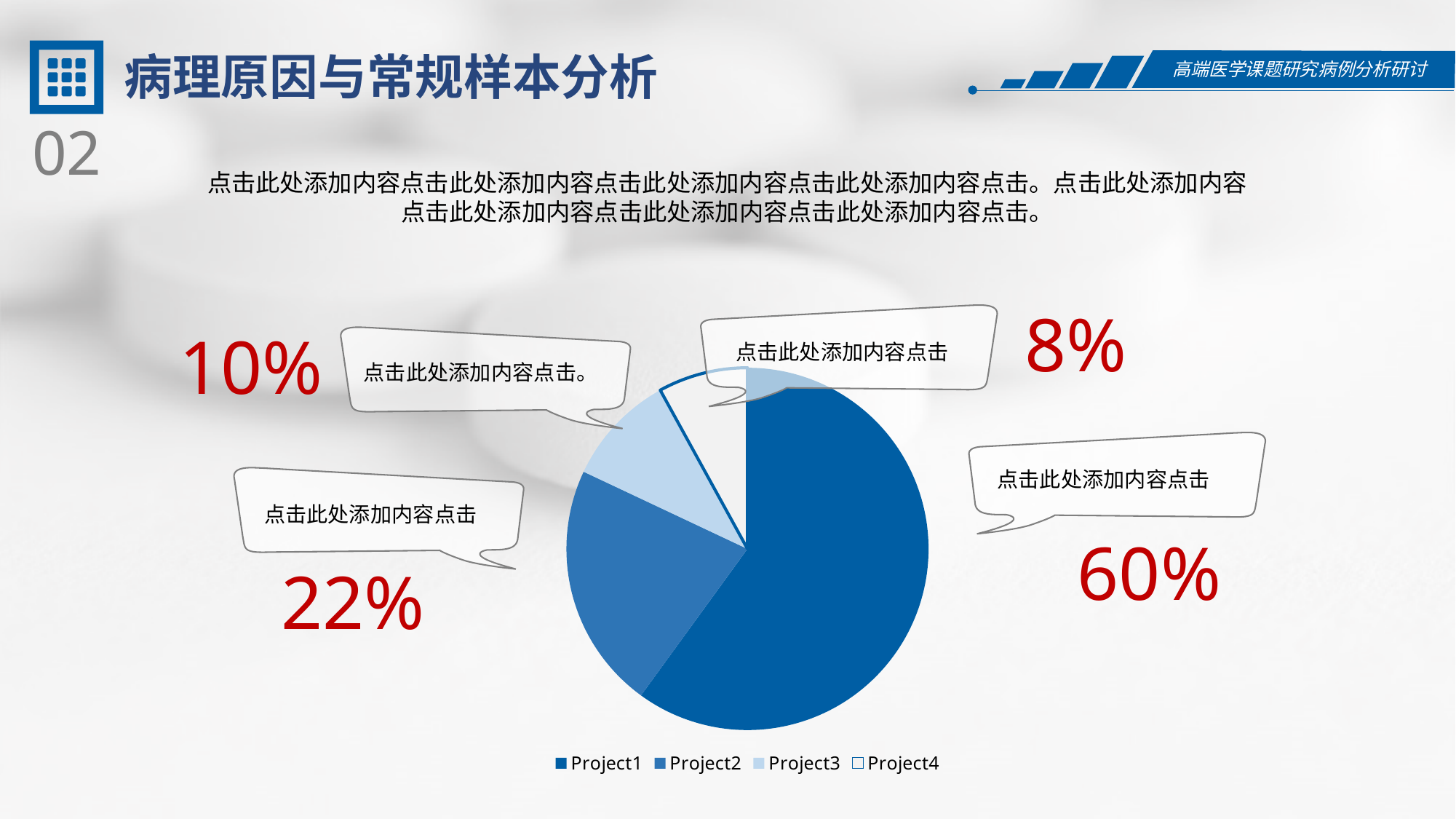
Which category has the largest slice in the pie chart? Project1 What kind of chart is shown on the slide? pie chart Does the Project1 slice take up more or less than half of the pie? more How many entries does the legend of the pie chart list? 4 Which slice is larger in the pie chart, Project2 or Project3? Project2 Which category has the smallest slice in the pie chart? Project4 What colour is the Project1 slice in the pie chart? dark blue What percentage is shown next to the callout pointing at the largest (Project1) slice? 60% Which slice is larger in the pie chart, Project1 or Project2? Project1 How many slices does the pie chart have? 4 What is the first entry listed in the pie chart's legend? Project1 What percentage is shown next to the callout pointing at the Project2 slice? 22%